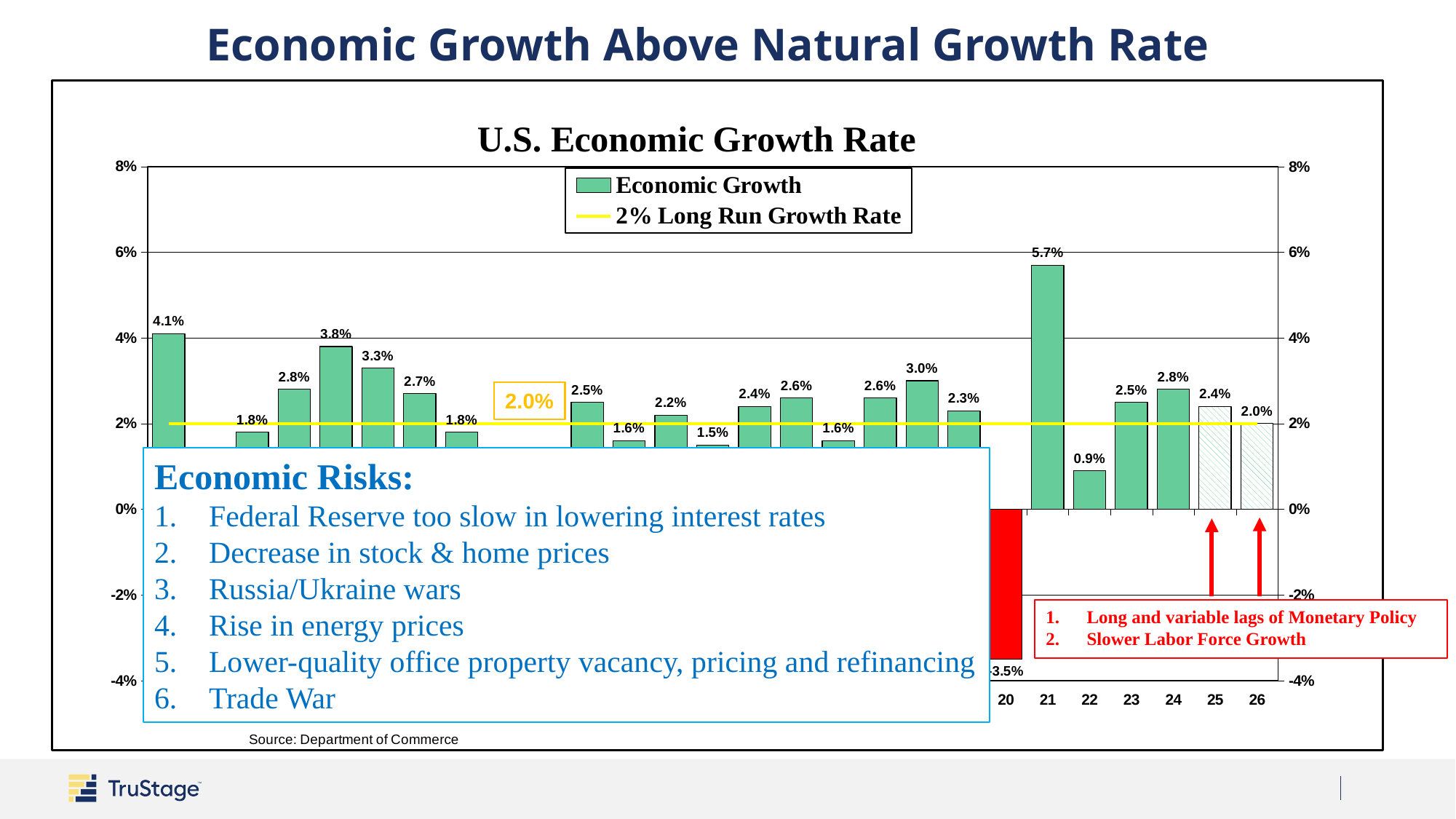
What kind of chart is used to show the economic growth values? Bar chart What is the economic growth rate shown for 26? 2.0% What is the economic growth rate shown for 21? 5.7% What is the difference between the economic growth rates for 21 and 22? 4.8 percentage points Is the economic growth rate for 21 greater or less than 4%? greater What is the economic growth rate shown for 22? 0.9% Which year among those labeled on the x axis has the lowest economic growth rate? 20 Which year has the higher economic growth rate, 23 or 24? 24 What is the title of the chart? U.S. Economic Growth Rate Which year among those labeled on the x axis has the highest economic growth rate? 21 Do the economic growth rates rise or fall from 24 to 26? Fall How many series does the legend list? 2